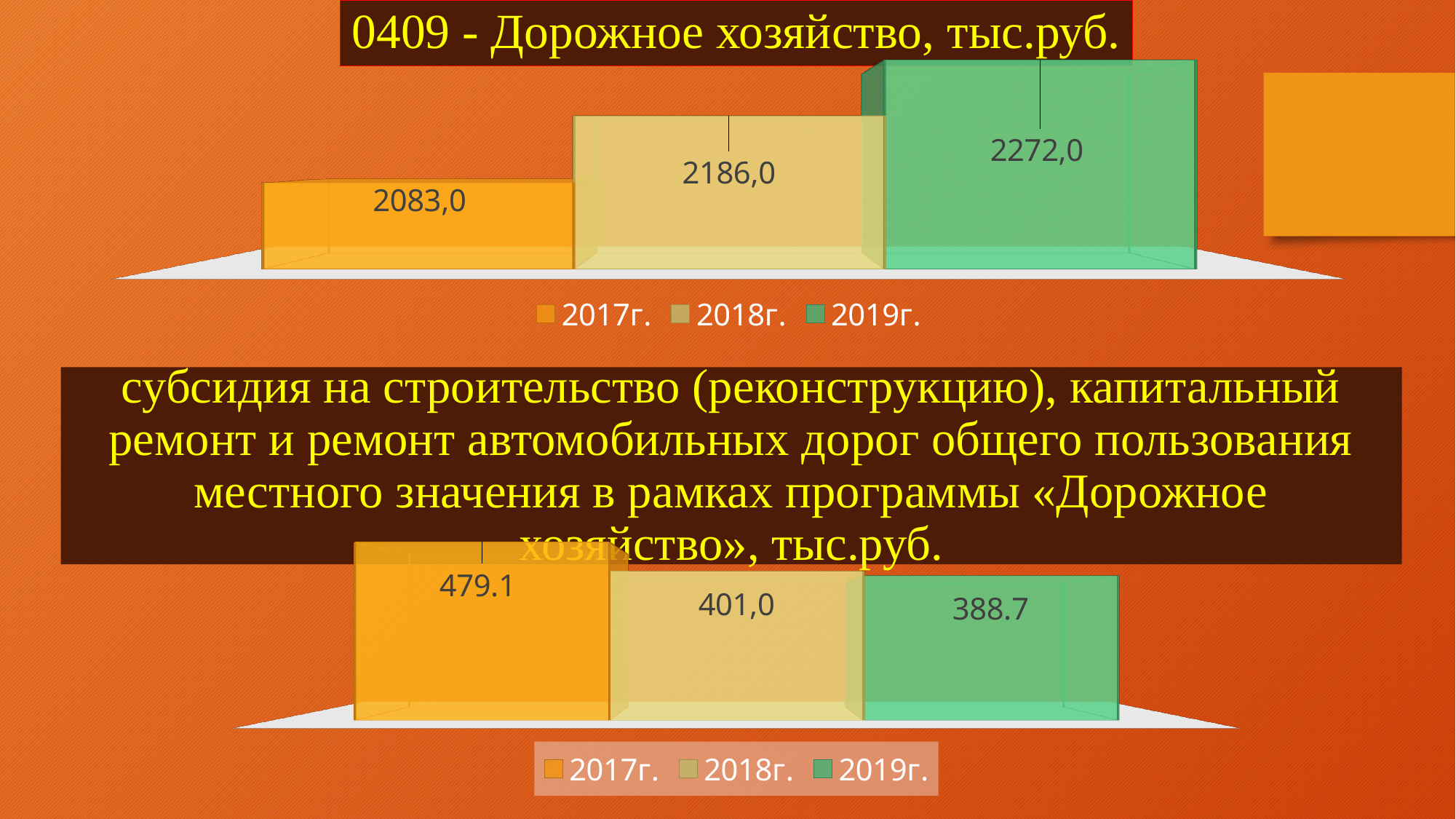
In the top chart (0409 - Дорожное хозяйство, тыс.руб.), what is the value for 2017г.? 2083,0 In the bottom chart (субсидия на строительство...), do the values rise or fall from 2017г. to 2019г.? fall In the top chart (0409 - Дорожное хозяйство, тыс.руб.), what is the difference between the 2019г. and 2017г. values? 189,0 In the bottom chart (субсидия на строительство...), which is larger, the value for 2017г. or for 2019г.? 2017г. In the bottom chart (субсидия на строительство...), what is the value for 2018г.? 401,0 In the top chart (0409 - Дорожное хозяйство, тыс.руб.), how many series does the legend list? 3 In the bottom chart (субсидия на строительство...), which year has the lowest value? 2019г. In the top chart (0409 - Дорожное хозяйство, тыс.руб.), what is the value for 2019г.? 2272,0 What kind of chart is the bottom chart (субсидия на строительство...)? bar chart In the top chart (0409 - Дорожное хозяйство, тыс.руб.), do the values rise or fall from 2017г. to 2019г.? rise In the top chart (0409 - Дорожное хозяйство, тыс.руб.), which year has the highest value? 2019г. In the bottom chart (субсидия на строительство...), what is the value for 2017г.? 479.1